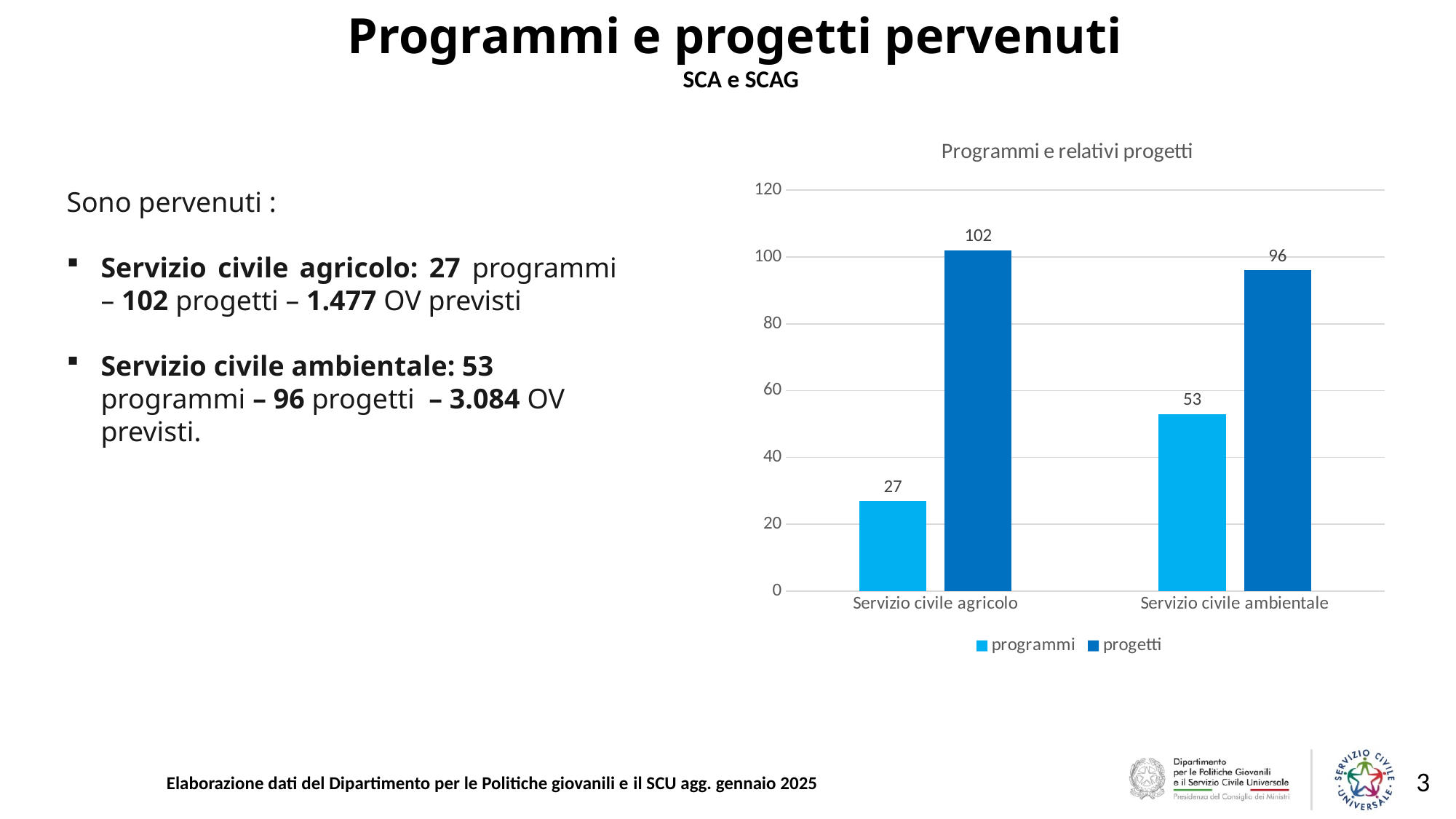
How many categories are shown on the x axis? 2 What is the title of the chart? Programmi e relativi progetti What is the value of progetti for Servizio civile agricolo? 102 What is the value of progetti for Servizio civile ambientale? 96 Which category has the lower value for progetti? Servizio civile ambientale What kind of chart is shown on the slide? bar chart What is the value of programmi for Servizio civile agricolo? 27 How many series does the legend list? 2 What is the difference in programmi between Servizio civile ambientale and Servizio civile agricolo? 26 What is the difference between progetti and programmi for Servizio civile agricolo? 75 Is the value of progetti for Servizio civile agricolo greater or less than 100? greater Which category has the higher value for programmi? Servizio civile ambientale